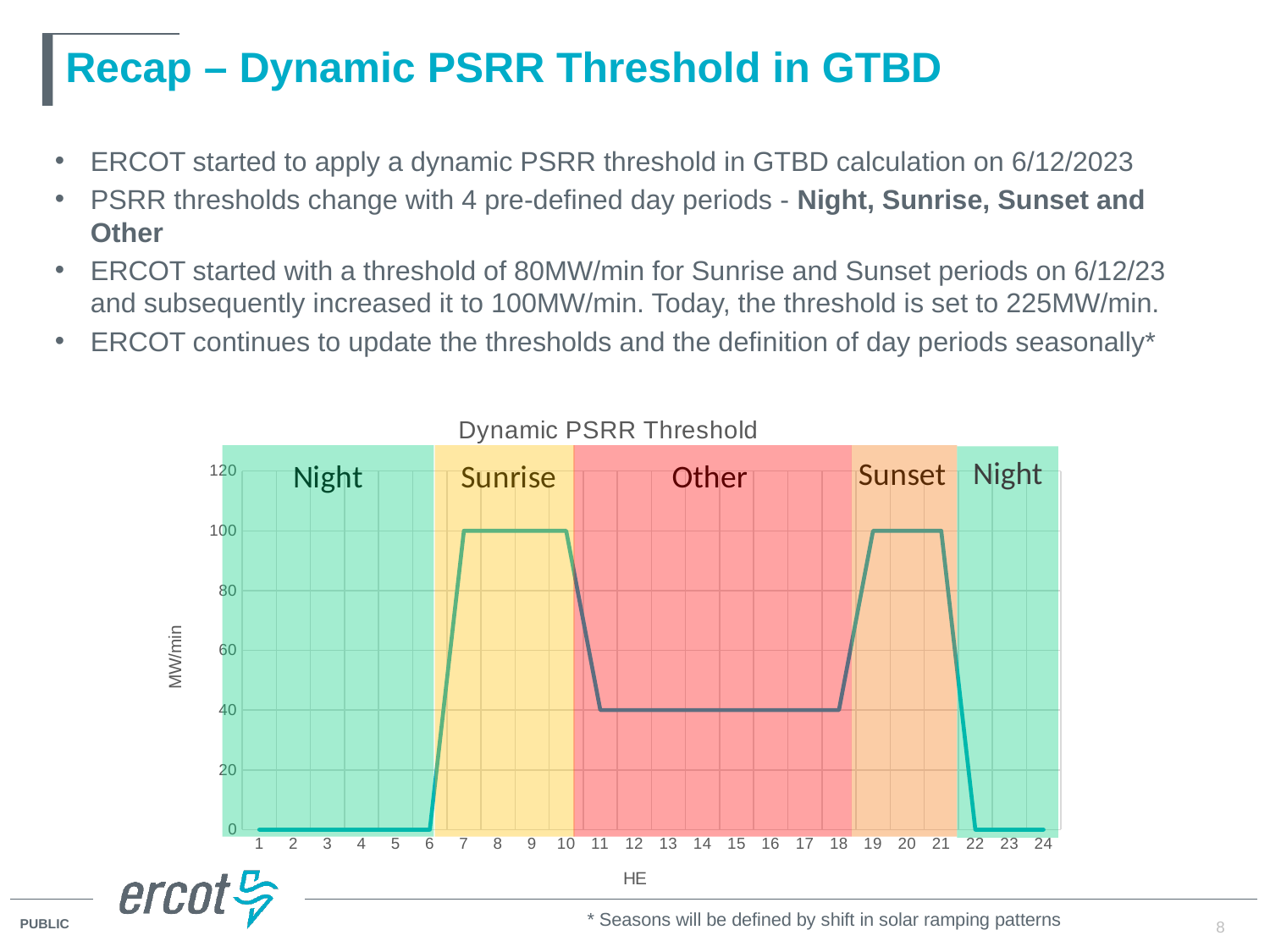
What kind of chart is shown under the title "Dynamic PSRR Threshold"? line chart Does the line rise or fall between HE 21 and HE 22? fall What is the value of the line at HE 3? 0 What is the difference between the line's value at HE 9 and its value at HE 15? 60 Is the value of the line at HE 16 greater or less than 60? less What is the value of the line at HE 8? 100 What is the label of the y axis of the chart? MW/min What is the value of the line at HE 14? 40 How many hour-ending (HE) points are shown on the x axis? 24 Which is larger, the value at HE 12 or the value at HE 19? HE 19 What is the title of the chart on the slide? Dynamic PSRR Threshold What is the value of the line at HE 20? 100